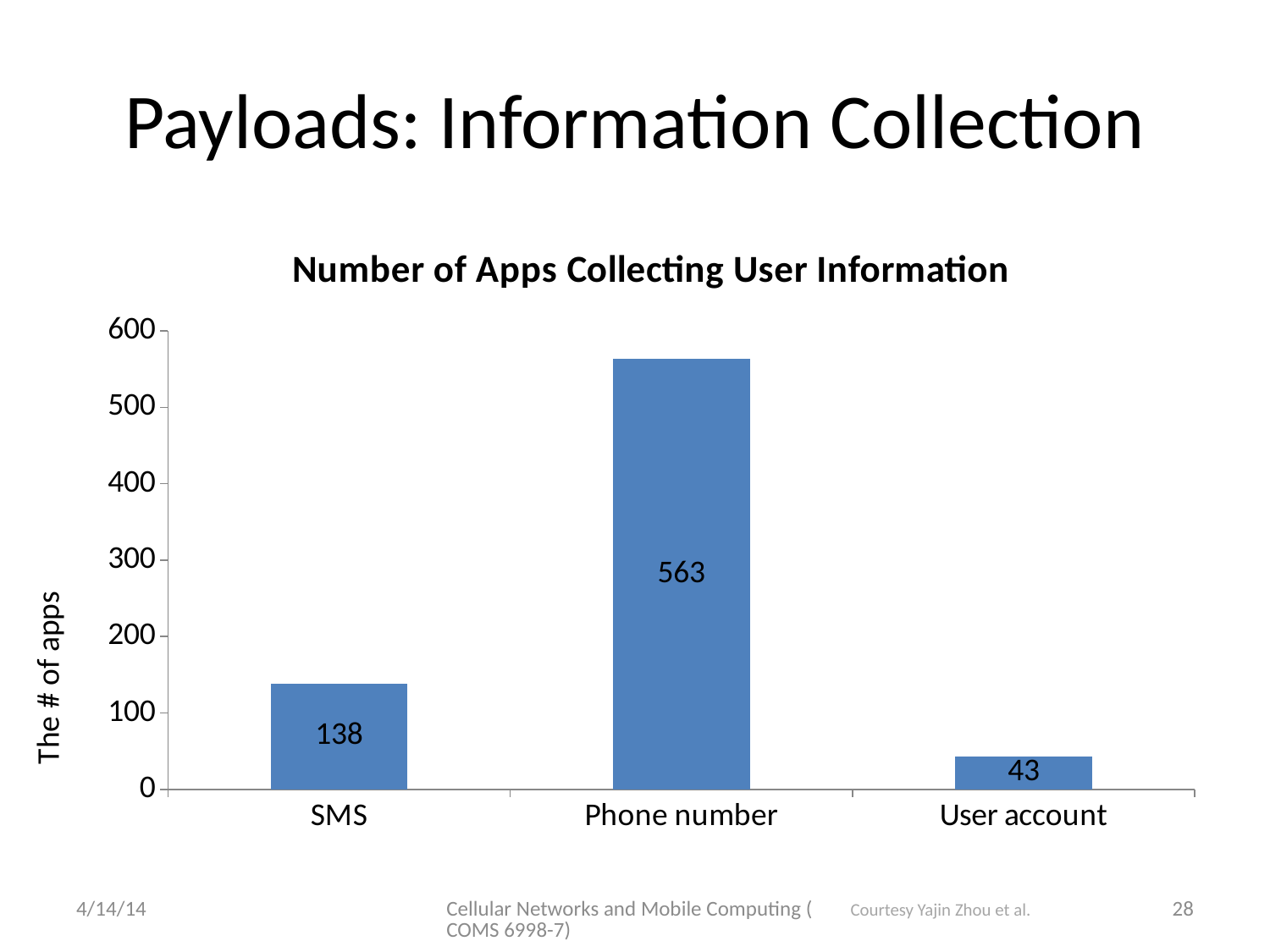
Is the value for Phone number greater or less than 500? greater What is the number of apps collecting User account? 43 What is the title of the chart? Number of Apps Collecting User Information What is the difference between the number of apps collecting Phone number and SMS? 425 What is the difference between the number of apps collecting SMS and User account? 95 Which is larger, the value for SMS or the value for User account? SMS Which category has the lowest number of apps? User account What is the number of apps collecting Phone number? 563 What is the number of apps collecting SMS? 138 Which category has the highest number of apps? Phone number How many categories are shown in the chart? 3 What kind of chart is shown on the slide? bar chart